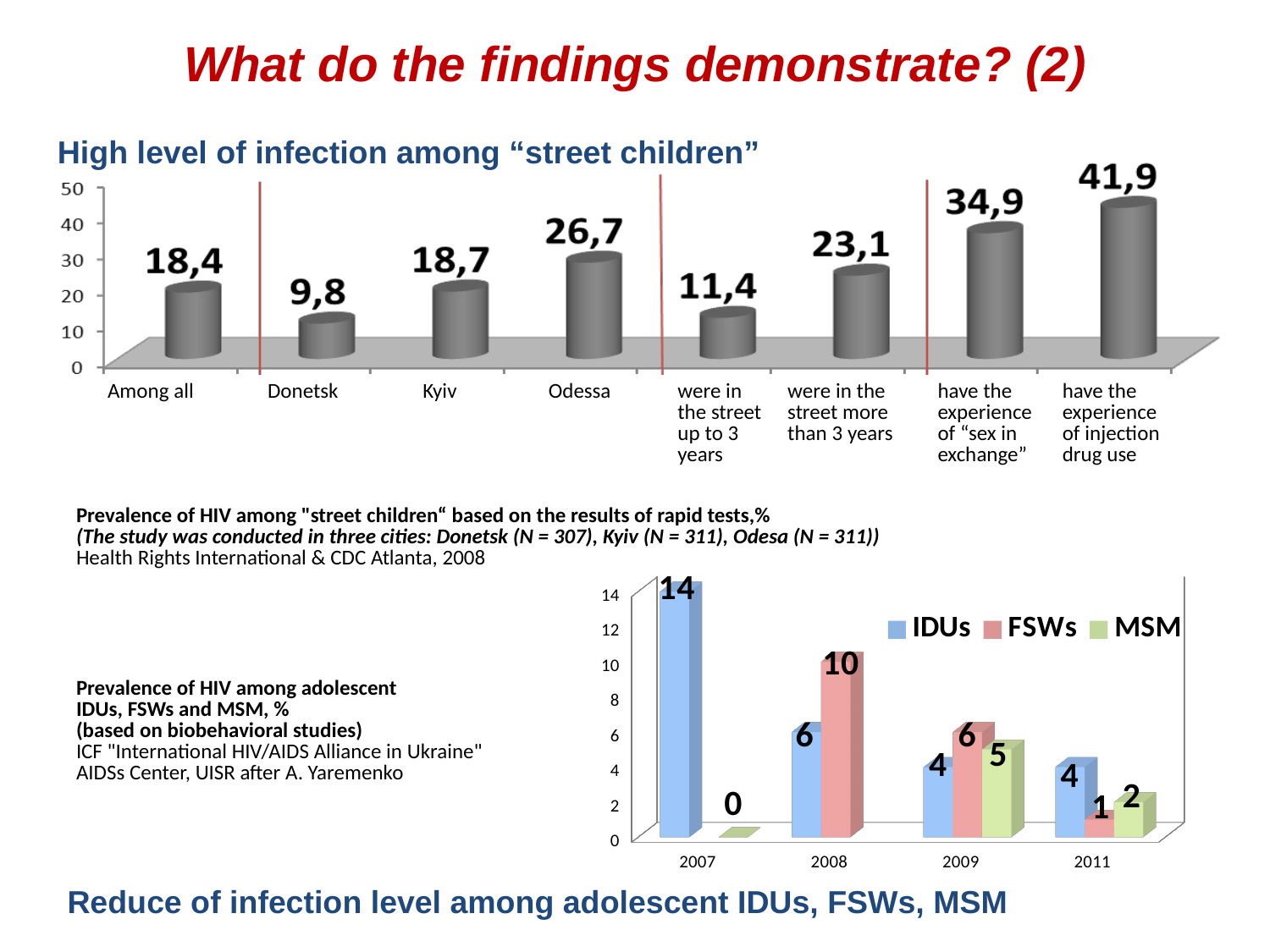
In the top chart on HIV prevalence among street children, what is the value for Odessa? 26,7 In the bottom chart on HIV prevalence among adolescent IDUs, FSWs and MSM, what is the value for IDUs in 2007? 14 In the top chart on HIV prevalence among street children, what is the difference between the value for those in the street more than 3 years and those in the street up to 3 years? 11,7 In the top chart on HIV prevalence among street children, which is larger: the value for Kyiv or the value for Among all? Kyiv How many series does the legend of the bottom chart list? 3 How many bars are shown in the top chart on HIV prevalence among street children? 8 In the top chart on HIV prevalence among street children, what is the value for Donetsk? 9,8 What kind of chart is the bottom chart on HIV prevalence among adolescent IDUs, FSWs and MSM? bar chart In the bottom chart on HIV prevalence among adolescent IDUs, FSWs and MSM, what is the value for FSWs in 2008? 10 In the top chart on HIV prevalence among street children, which category has the lowest value? Donetsk In the top chart on HIV prevalence among street children, which category has the highest value? have the experience of injection drug use In the bottom chart, does the value for IDUs rise or fall from 2007 to 2011? fall